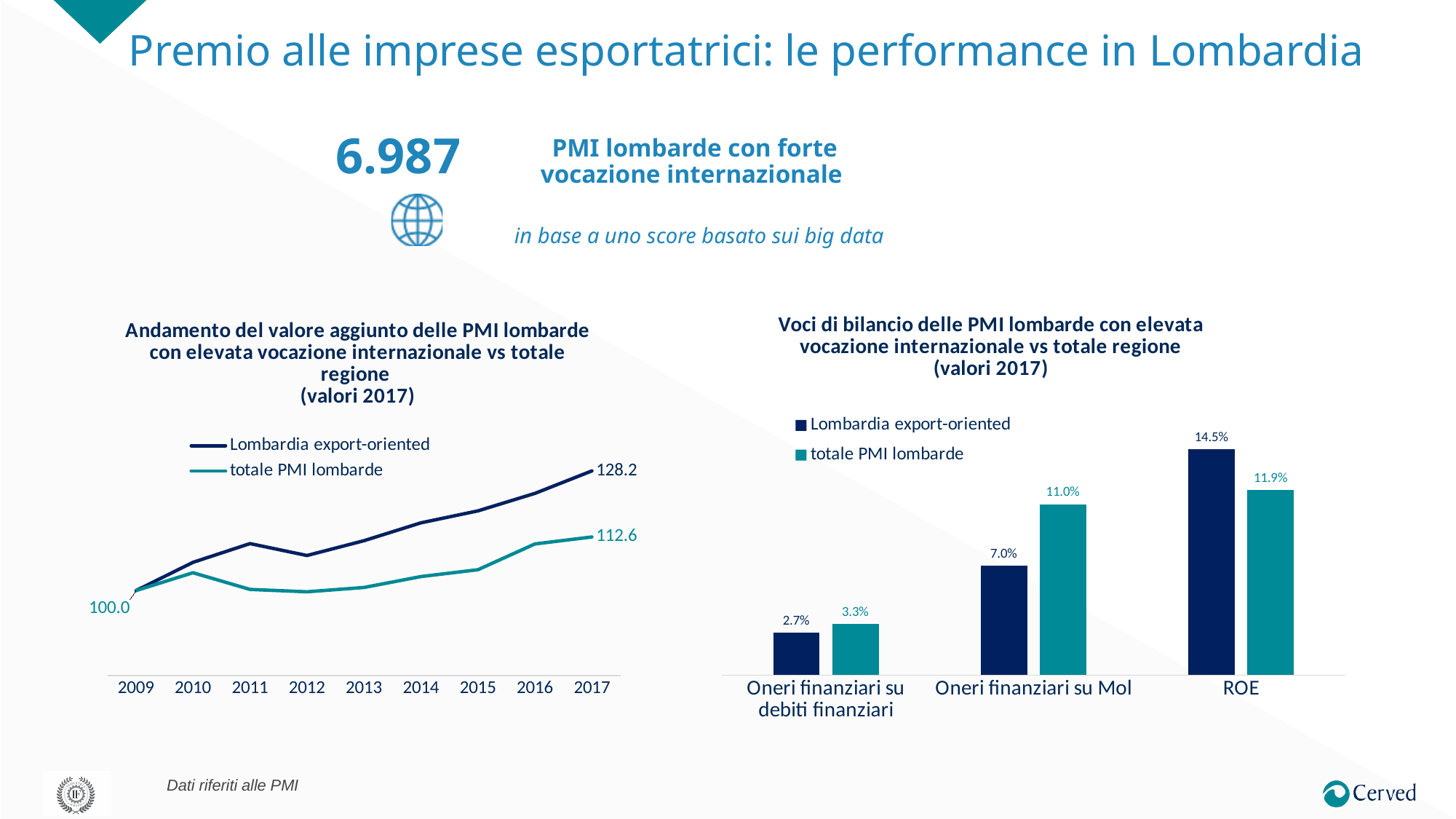
In the right chart (Voci di bilancio), what is the value of Oneri finanziari su Mol for totale PMI lombarde? 11.0% In the left chart (Andamento del valore aggiunto), what is the 2017 value for totale PMI lombarde? 112.6 In the right chart (Voci di bilancio), what is the ROE value for Lombardia export-oriented? 14.5% In the left chart (Andamento del valore aggiunto), what kind of chart is it? line chart In the left chart (Andamento del valore aggiunto), what is the 2017 value for Lombardia export-oriented? 128.2 In the left chart (Andamento del valore aggiunto), does the Lombardia export-oriented series rise or fall overall from 2009 to 2017? rise In the right chart (Voci di bilancio), which category has the highest value for Lombardia export-oriented? ROE In the left chart (Andamento del valore aggiunto), what is the difference between the 2017 values of Lombardia export-oriented and totale PMI lombarde? 15.6 In the right chart (Voci di bilancio), which is larger for Oneri finanziari su debiti finanziari: Lombardia export-oriented or totale PMI lombarde? totale PMI lombarde In the left chart (Andamento del valore aggiunto), how many years are shown on the x axis? 9 In the right chart (Voci di bilancio), what is the difference between the two series for Oneri finanziari su Mol? 4.0% In the right chart (Voci di bilancio), how many series does the legend list? 2